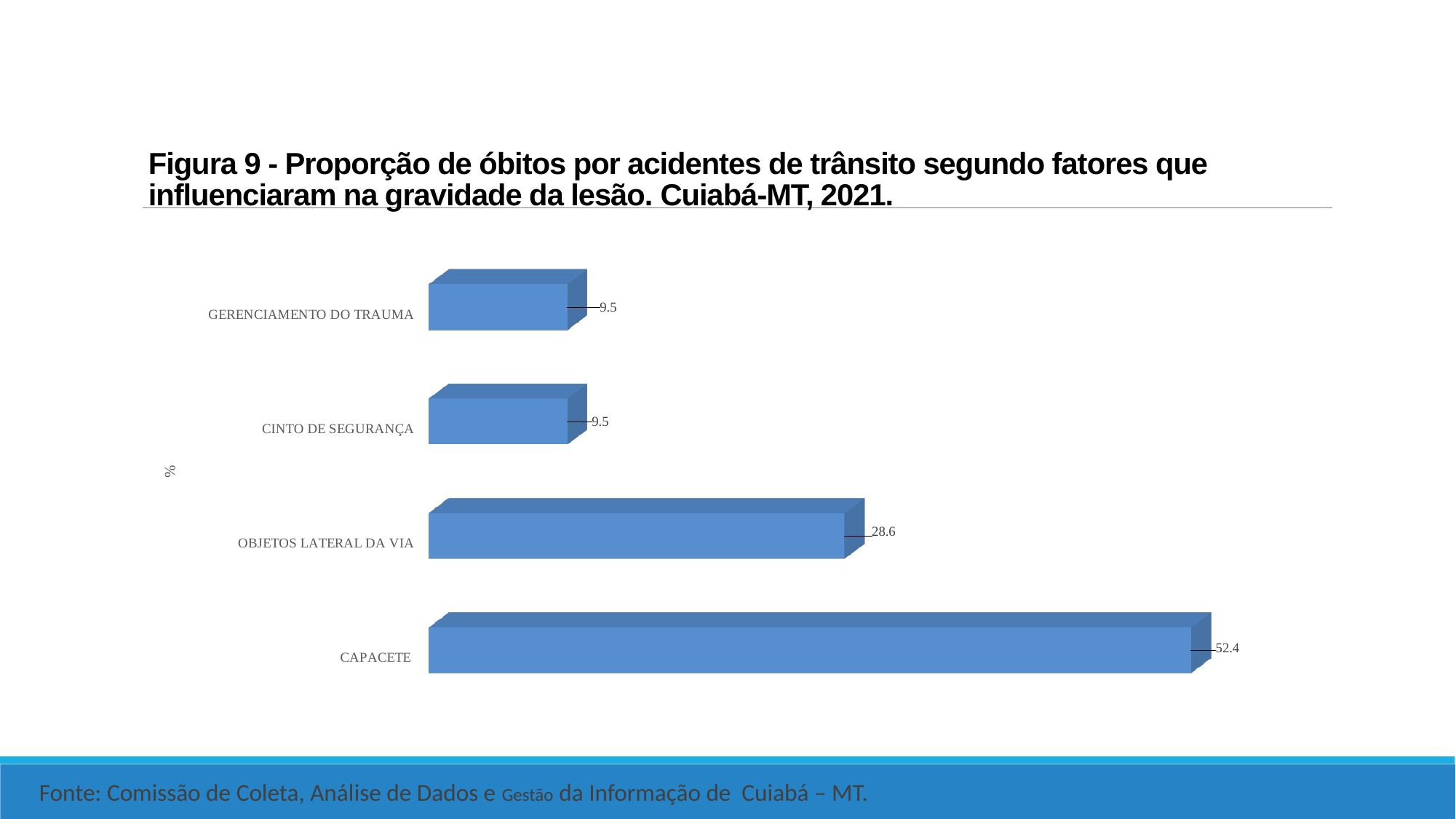
What is the figure number given in the chart title? Figura 9 Which category has the highest value? CAPACETE What is the value for GERENCIAMENTO DO TRAUMA? 9.5 What is the difference between the values for OBJETOS LATERAL DA VIA and CINTO DE SEGURANÇA? 19.1 What kind of chart is shown on the slide? Bar chart What is the label on the vertical axis of the chart? % Which is larger, the value for CAPACETE or the value for OBJETOS LATERAL DA VIA? CAPACETE What is the difference between the values for CAPACETE and OBJETOS LATERAL DA VIA? 23.8 What is the value for CINTO DE SEGURANÇA? 9.5 What is the value for CAPACETE? 52.4 How many categories are shown in the chart? 4 What is the value for OBJETOS LATERAL DA VIA? 28.6